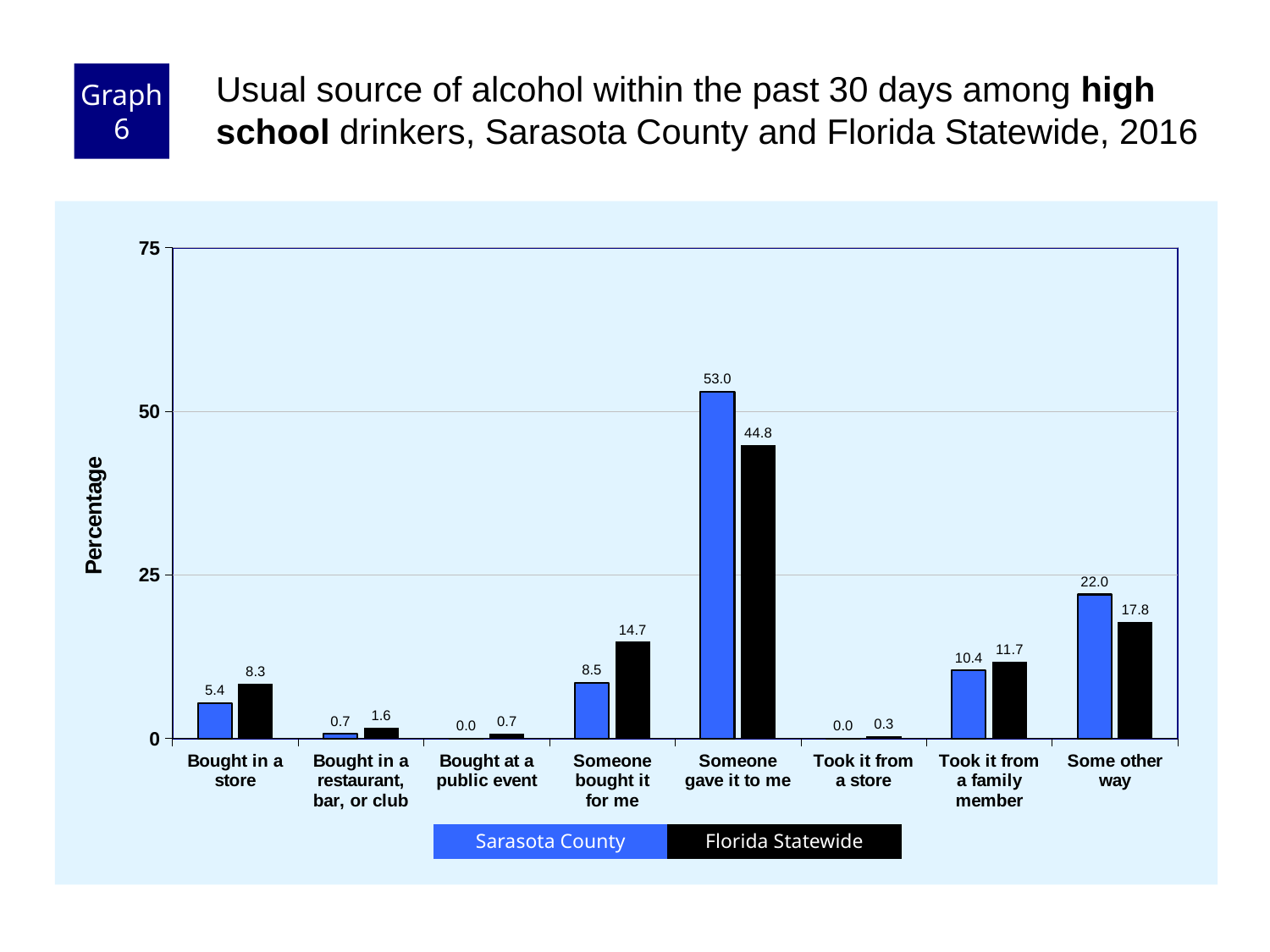
How many series does the legend list? 2 For "Some other way", which is larger: Sarasota County or Florida Statewide? Sarasota County What is the Florida Statewide value for "Someone bought it for me"? 14.7 What is the Sarasota County value for "Took it from a family member"? 10.4 What is the difference between the Sarasota County and Florida Statewide values for "Someone gave it to me"? 8.2 Which category has the lowest Florida Statewide value? Took it from a store How many categories are shown on the x axis? 8 Which category has the highest Florida Statewide value? Someone gave it to me What is the difference between the Florida Statewide and Sarasota County values for "Bought in a store"? 2.9 What is the Sarasota County value for "Someone gave it to me"? 53.0 What kind of chart is shown on the slide? Bar chart Is the Sarasota County value for "Someone gave it to me" greater or less than 50? greater